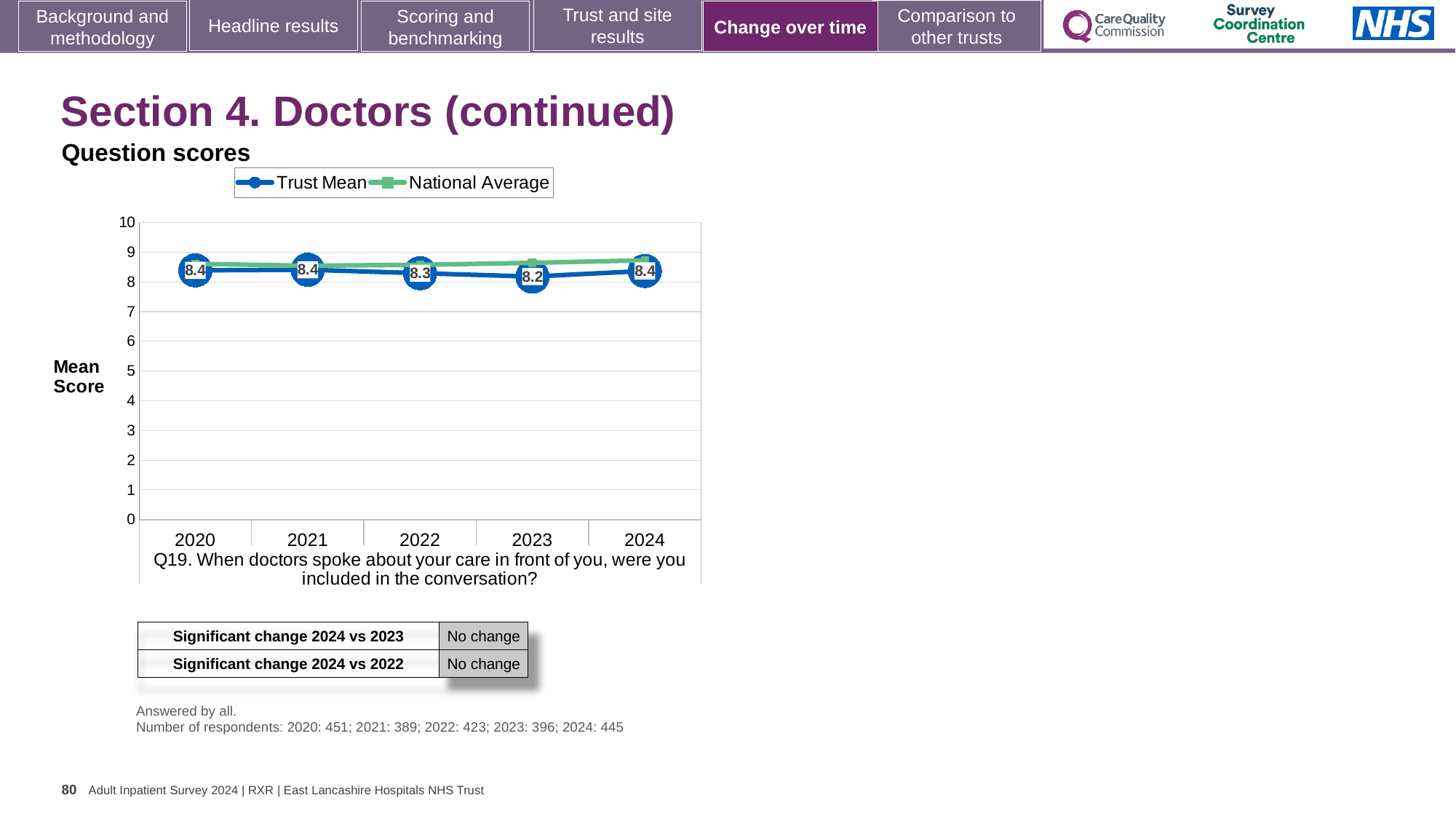
What is the Trust Mean score for 2023? 8.2 What is the Trust Mean score for 2020? 8.4 Which year has the larger Trust Mean score, 2022 or 2023? 2022 What is the Trust Mean score for 2022? 8.3 What is the difference between the Trust Mean scores for 2024 and 2023? 0.2 How many years are plotted on the x axis? 5 Is the National Average value for 2024 greater or less than 8? greater How many series does the legend list? 2 In which year is the Trust Mean score lowest? 2023 What is the Trust Mean score for 2024? 8.4 Does the Trust Mean score rise or fall from 2021 to 2023? fall What kind of chart is shown? line chart